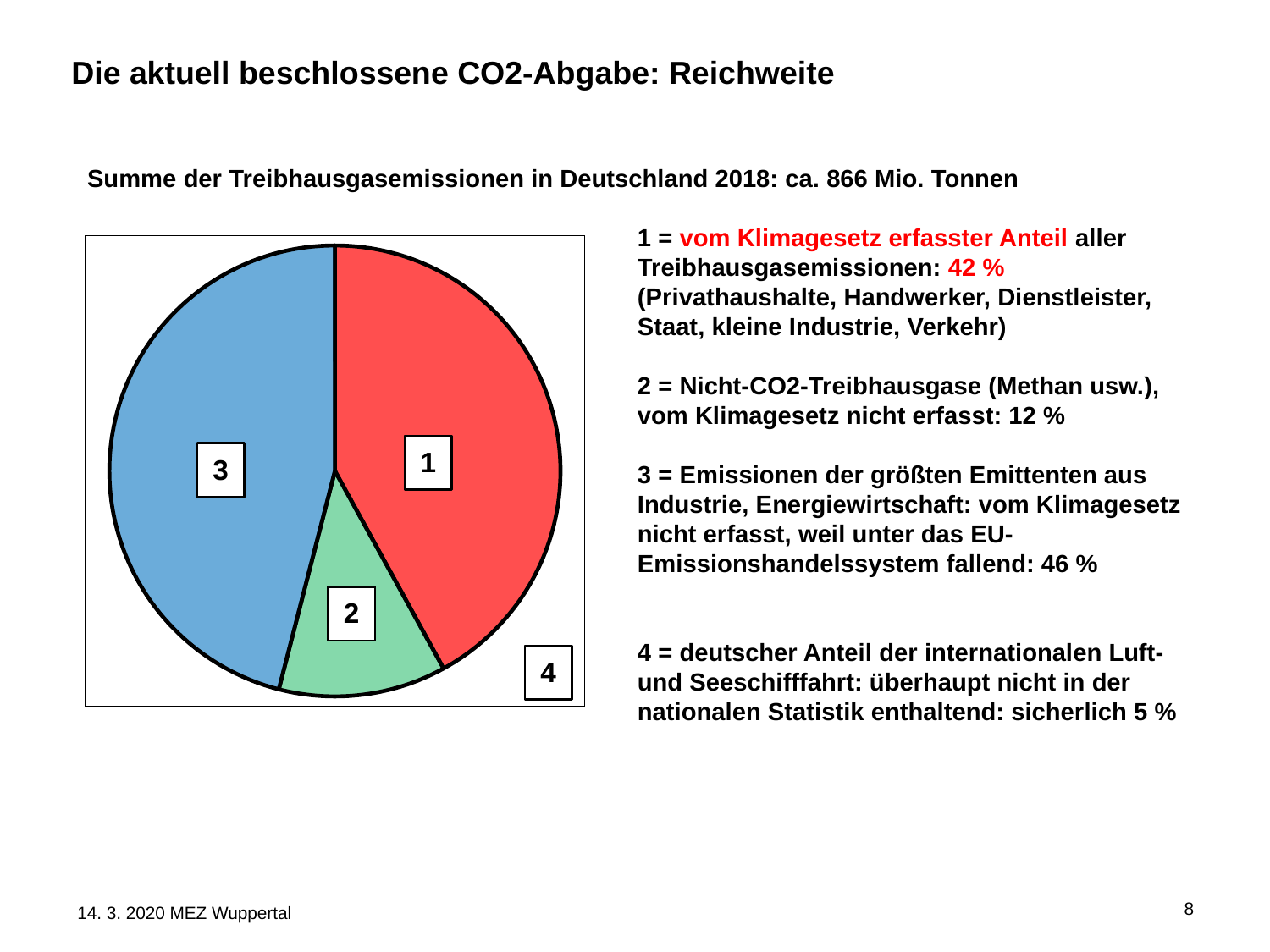
According to the slide, what share does segment 3 (Emissionen der größten Emittenten) represent? 46 % How many coloured segments does the pie chart contain? 3 According to the slide, what share of greenhouse gas emissions does segment 1 (vom Klimagesetz erfasster Anteil) represent? 42 % What total of greenhouse gas emissions for Germany in 2018 is stated above the chart? ca. 866 Mio. Tonnen According to the slide, what share does segment 2 (Nicht-CO2-Treibhausgase) represent? 12 % By how many percentage points is segment 3 larger than segment 1? 4 % Which segment of the pie chart is the largest? 3 What kind of chart is shown on the slide? pie chart By how many percentage points is segment 1 larger than segment 2? 30 % Which segment of the pie chart is the smallest? 2 What colour is segment 1 in the pie chart? red Which is larger, segment 1 or segment 3 of the pie chart? 3